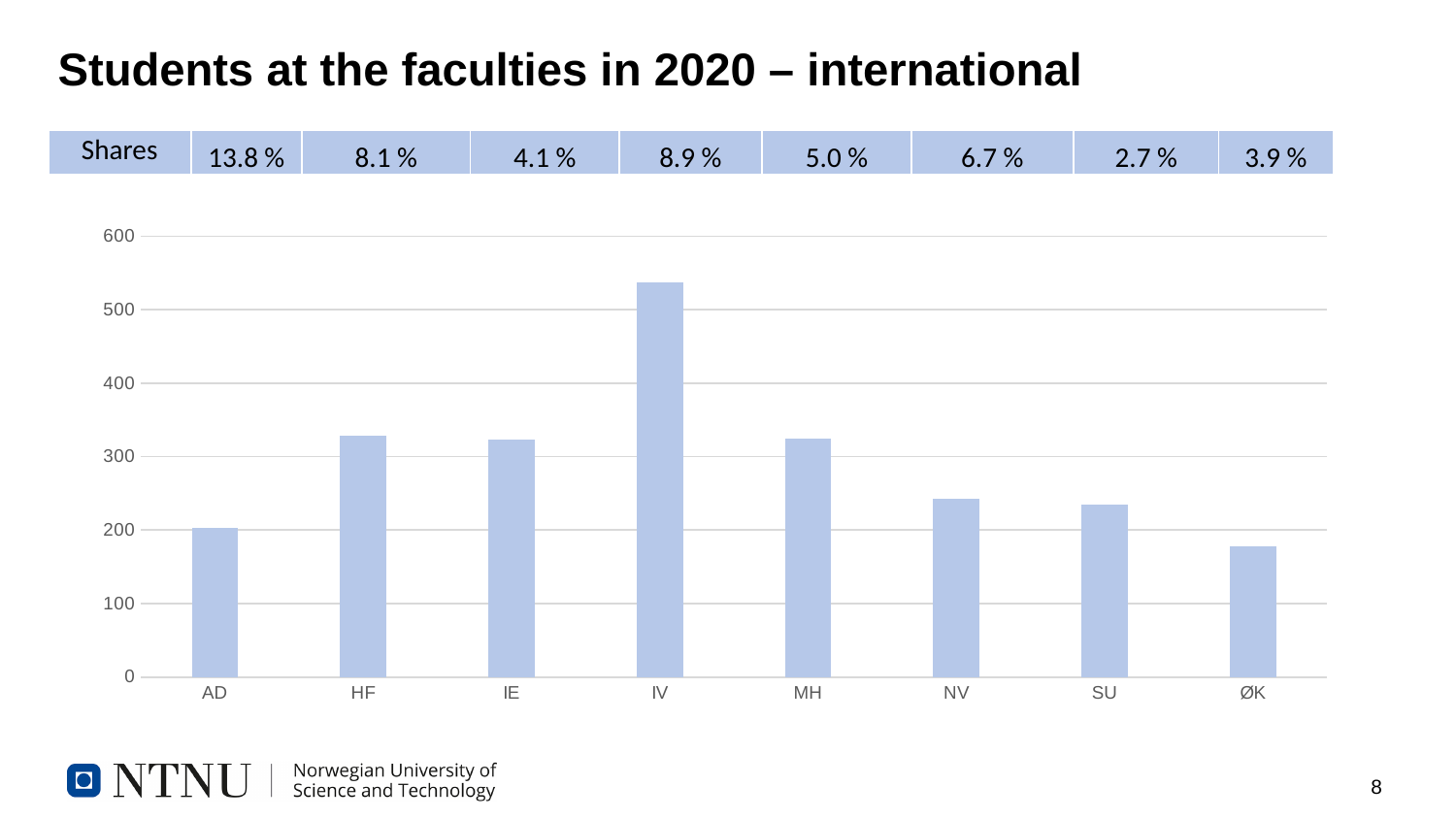
Is the value for HF greater or less than 300? greater Which has the larger value, IV or HF? IV Is the value for IV greater or less than 500? greater How many faculties are shown on the x axis of the chart? 8 Which faculty has the lowest bar in the chart? ØK Is the value for AD greater or less than 300? less Which faculty has the highest bar in the chart? IV What is the title of the slide containing the chart? Students at the faculties in 2020 – international What kind of chart is shown on the slide? bar chart Which has the larger value, AD or NV? NV